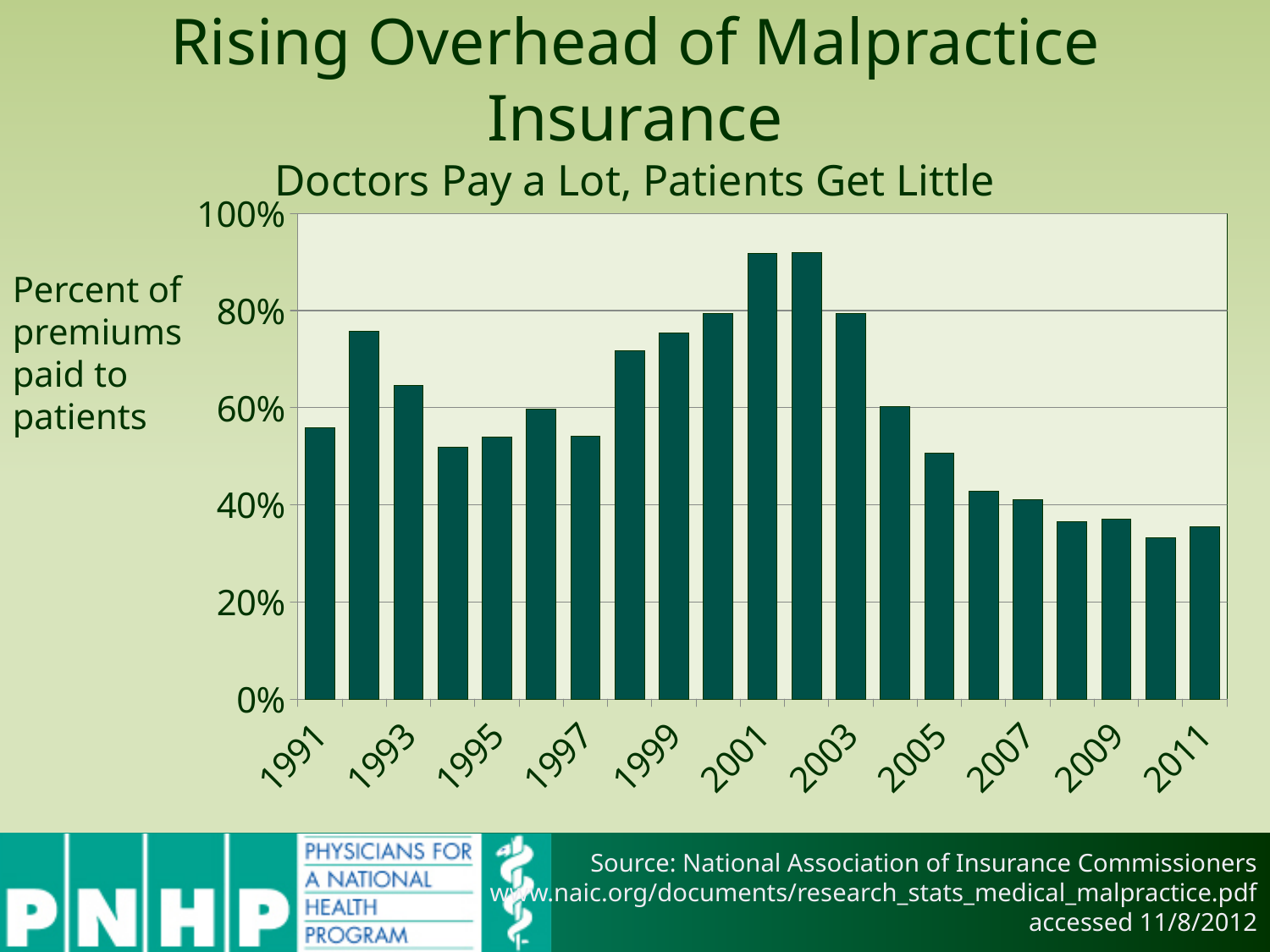
Is the value for 1991 greater or less than 40%? greater Do the values generally rise or fall from 2003 to 2011? fall How many bars (years) are plotted in the chart? 21 What kind of chart is shown on the slide? bar chart Which year has the larger value, 1991 or 2011? 1991 Is the value for 2009 greater or less than 40%? less Is the value for 2011 greater or less than 40%? less What quantity does the chart plot, according to the label to the left of the chart? Percent of premiums paid to patients Which year has the larger value, 1999 or 2005? 1999